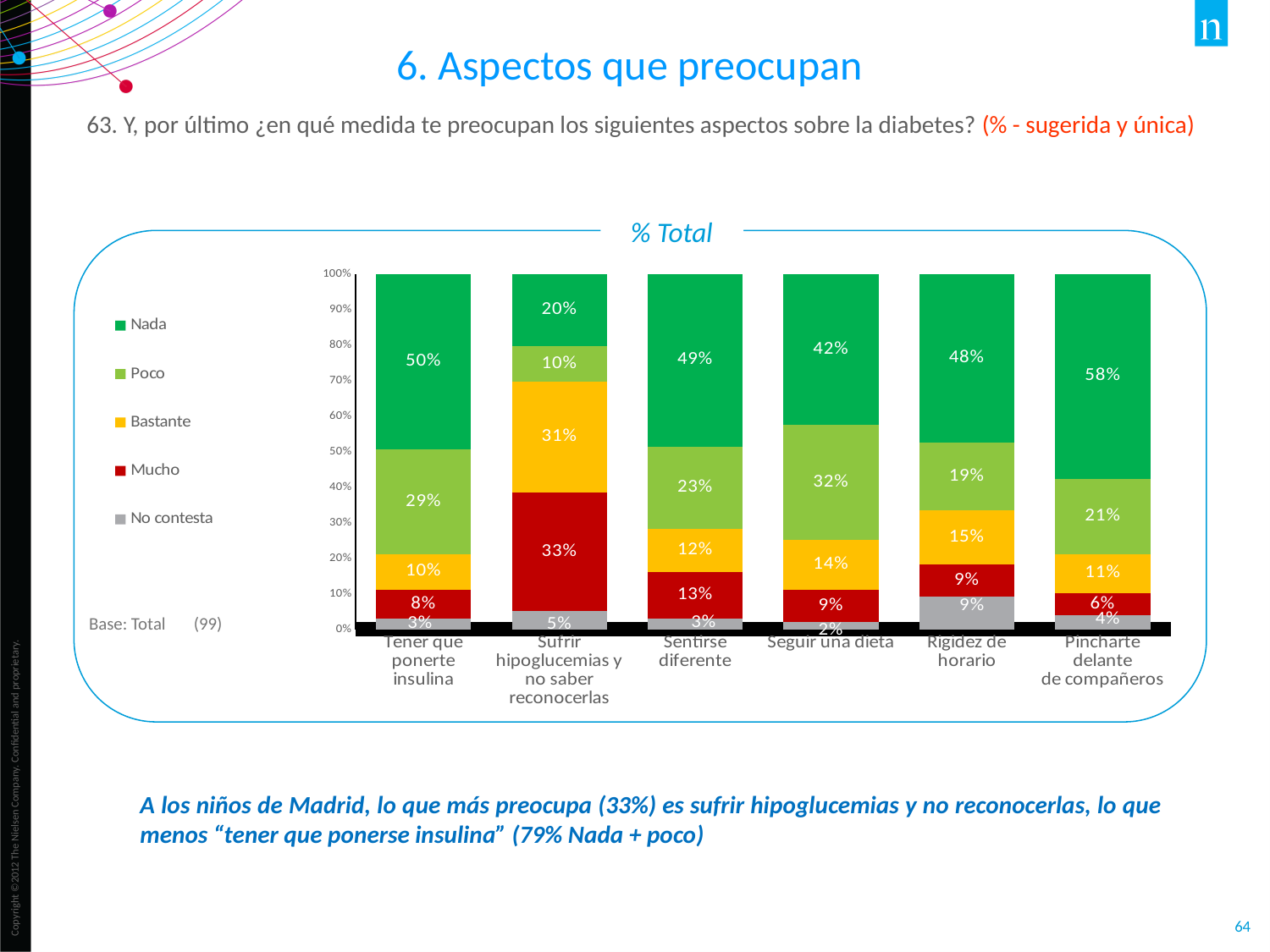
What kind of chart is shown on the slide? Stacked bar chart Which category has the highest 'Nada' value? Pincharte delante de compañeros Which category has the lowest 'Nada' value? Sufrir hipoglucemias y no saber reconocerlas How many categories (aspects) are shown on the x axis of the chart? 6 What is the 'Mucho' value for 'Sufrir hipoglucemias y no saber reconocerlas'? 33% Which legend entry is shown in red? Mucho Which is larger: the 'Mucho' value for 'Sentirse diferente' or the 'Mucho' value for 'Rigidez de horario'? Sentirse diferente How many series does the chart legend list? 5 What is the total of the stacked bar for 'Tener que ponerte insulina'? 100% What is the 'Nada' value for 'Pincharte delante de compañeros'? 58% What is the 'Poco' value for 'Seguir una dieta'? 32% What is the difference between the 'Bastante' value for 'Sufrir hipoglucemias y no saber reconocerlas' and the 'Bastante' value for 'Tener que ponerte insulina'? 21%